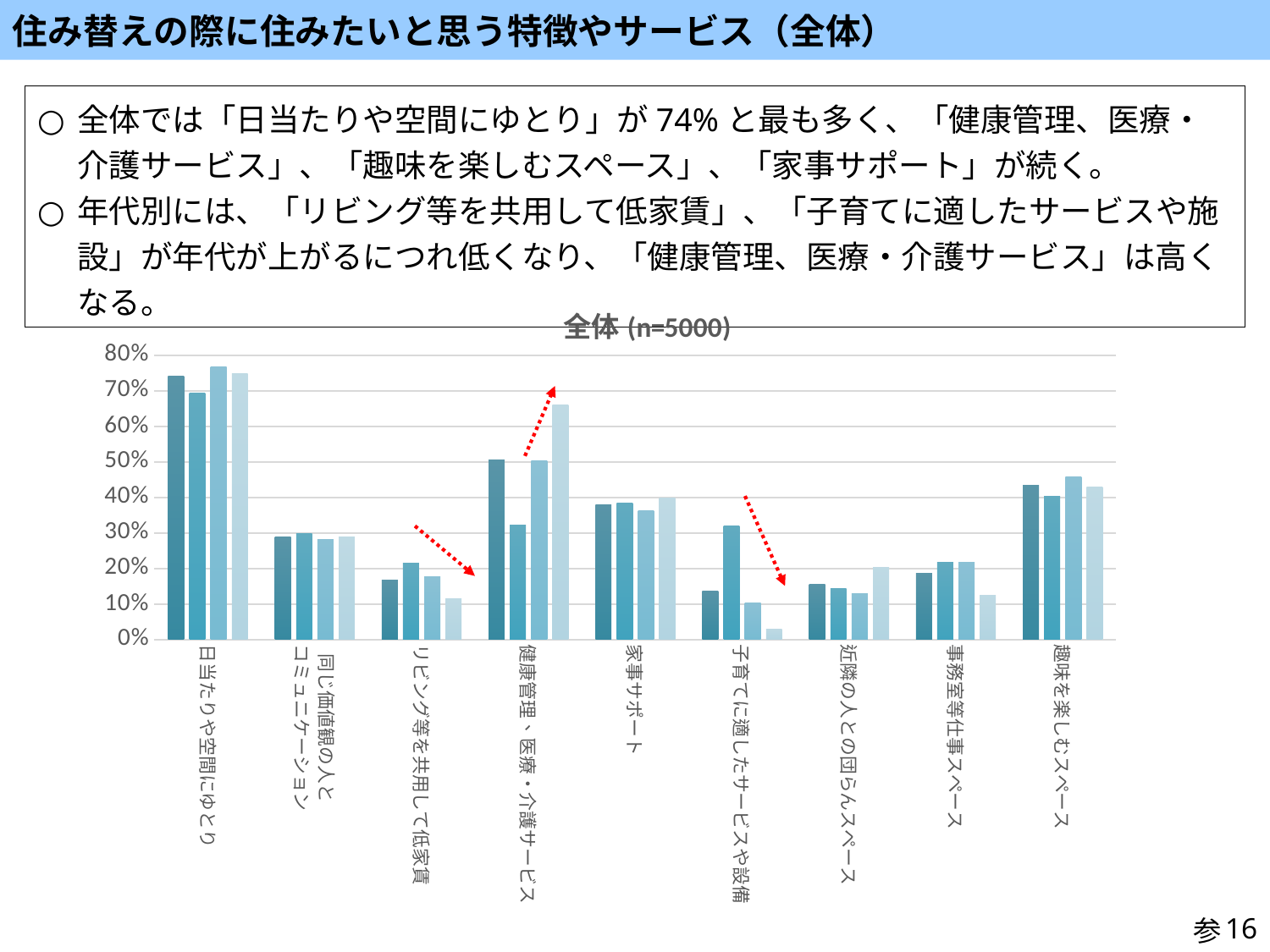
How many categories are shown along the x axis of the chart? 9 How many red dotted arrows are drawn on the chart? 3 Which category contains the shortest single bar in the chart? 子育てに適したサービスや設備 What kind of chart is shown on the slide? bar chart Is the value of the fourth (rightmost) bar for 健康管理・医療・介護サービス greater or less than 60%? greater How many bars are plotted for each category in the chart? 4 Is the value of the fourth (rightmost) bar for 事務室等仕事スペース greater or less than 20%? less Which has the larger first bar: 日当たりや空間にゆとり or 家事サポート? 日当たりや空間にゆとり What is the title of the chart? 全体 (n=5000) Which category has the tallest bars in the chart? 日当たりや空間にゆとり Is the value of the first bar for 家事サポート greater or less than 50%? less